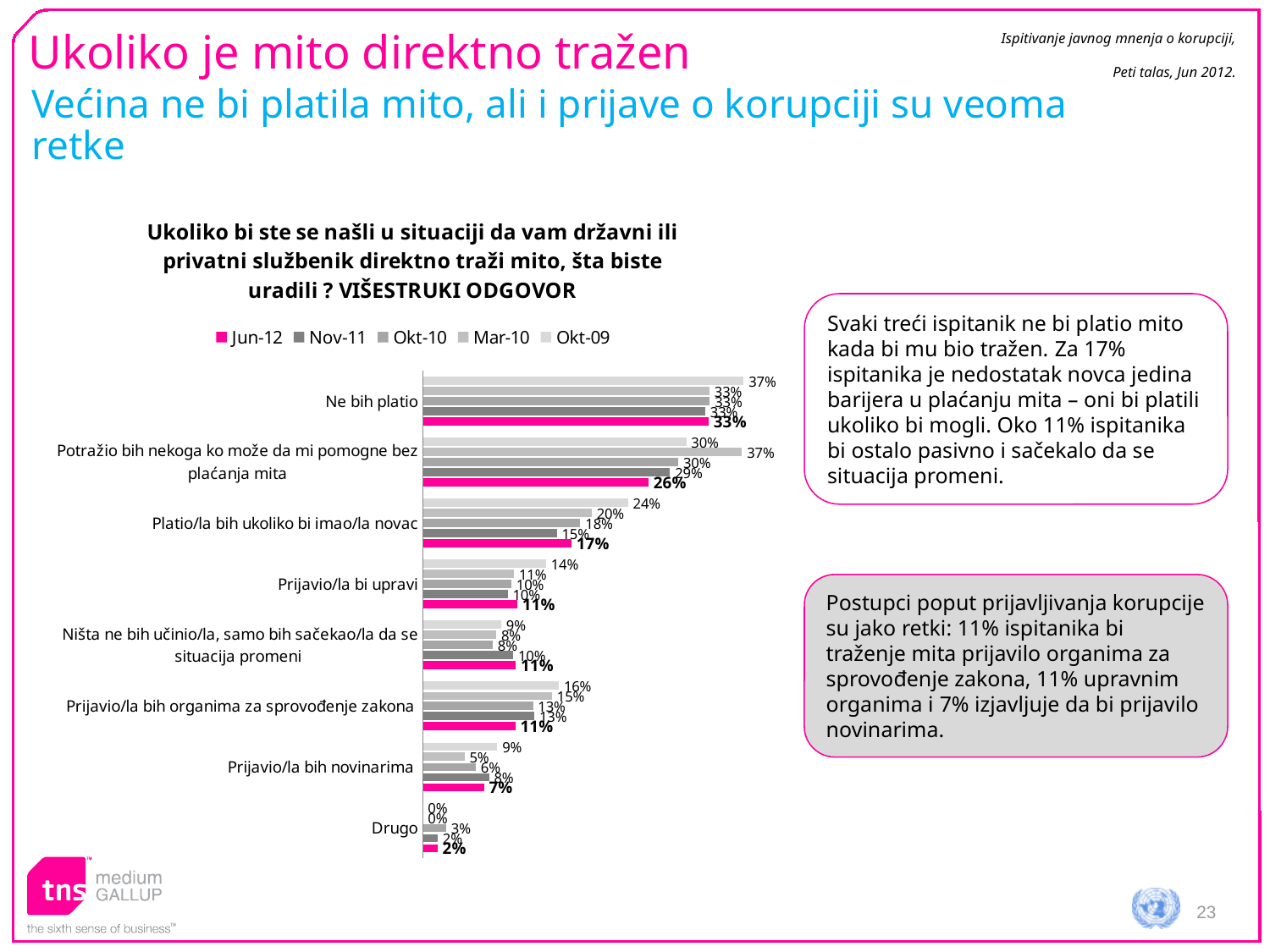
What is the difference between the Jun-12 values for "Ne bih platio" and "Potražio bih nekoga ko može da mi pomogne bez plaćanja mita"? 7% What is the Jun-12 value for "Platio/la bih ukoliko bi imao/la novac"? 17% What kind of chart is shown on the slide? bar chart How many categories are shown on the chart? 8 Which is larger for Jun-12: "Platio/la bih ukoliko bi imao/la novac" or "Prijavio/la bih novinarima"? Platio/la bih ukoliko bi imao/la novac Which category has the lowest Jun-12 value? Drugo Which category has the highest Jun-12 value? Ne bih platio What is the Jun-12 value for "Potražio bih nekoga ko može da mi pomogne bez plaćanja mita"? 26% What is the Jun-12 value for "Ne bih platio"? 33% What is the Jun-12 value for "Prijavio/la bih novinarima"? 7% How many series does the legend list? 5 What is the Okt-09 value for "Ne bih platio"? 37%